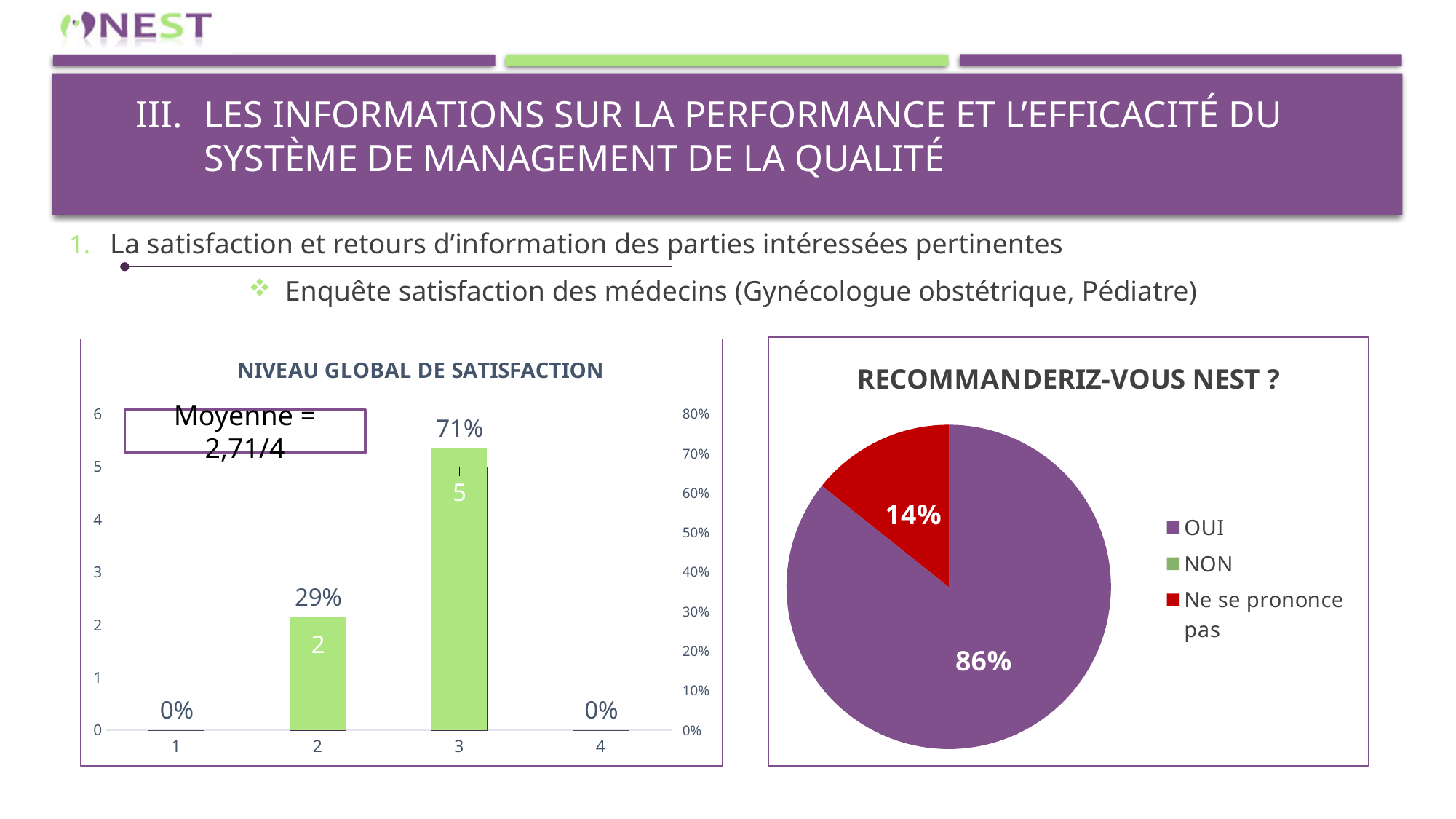
In the 'NIVEAU GLOBAL DE SATISFACTION' chart, what is the difference in percentage points between category 3 and category 2? 42% What type of chart is 'NIVEAU GLOBAL DE SATISFACTION'? Bar chart In the 'NIVEAU GLOBAL DE SATISFACTION' chart, what count is printed on the bar for category 2? 2 How many entries does the legend of the 'RECOMMANDERIZ-VOUS NEST ?' chart list? 3 In the 'NIVEAU GLOBAL DE SATISFACTION' chart, what percentage is shown for category 3? 71% In the 'RECOMMANDERIZ-VOUS NEST ?' chart, what share of the pie is 'Ne se prononce pas'? 14% In the 'NIVEAU GLOBAL DE SATISFACTION' chart, what count is printed on the bar for category 3? 5 In the 'NIVEAU GLOBAL DE SATISFACTION' chart, how many categories are shown on the x axis? 4 In the 'NIVEAU GLOBAL DE SATISFACTION' chart, which category has the highest value? 3 In the 'RECOMMANDERIZ-VOUS NEST ?' chart, what share of the pie is 'OUI'? 86% In the 'NIVEAU GLOBAL DE SATISFACTION' chart, what average (Moyenne) is stated in the box? 2,71/4 In the 'NIVEAU GLOBAL DE SATISFACTION' chart, what percentage is shown for category 2? 29%